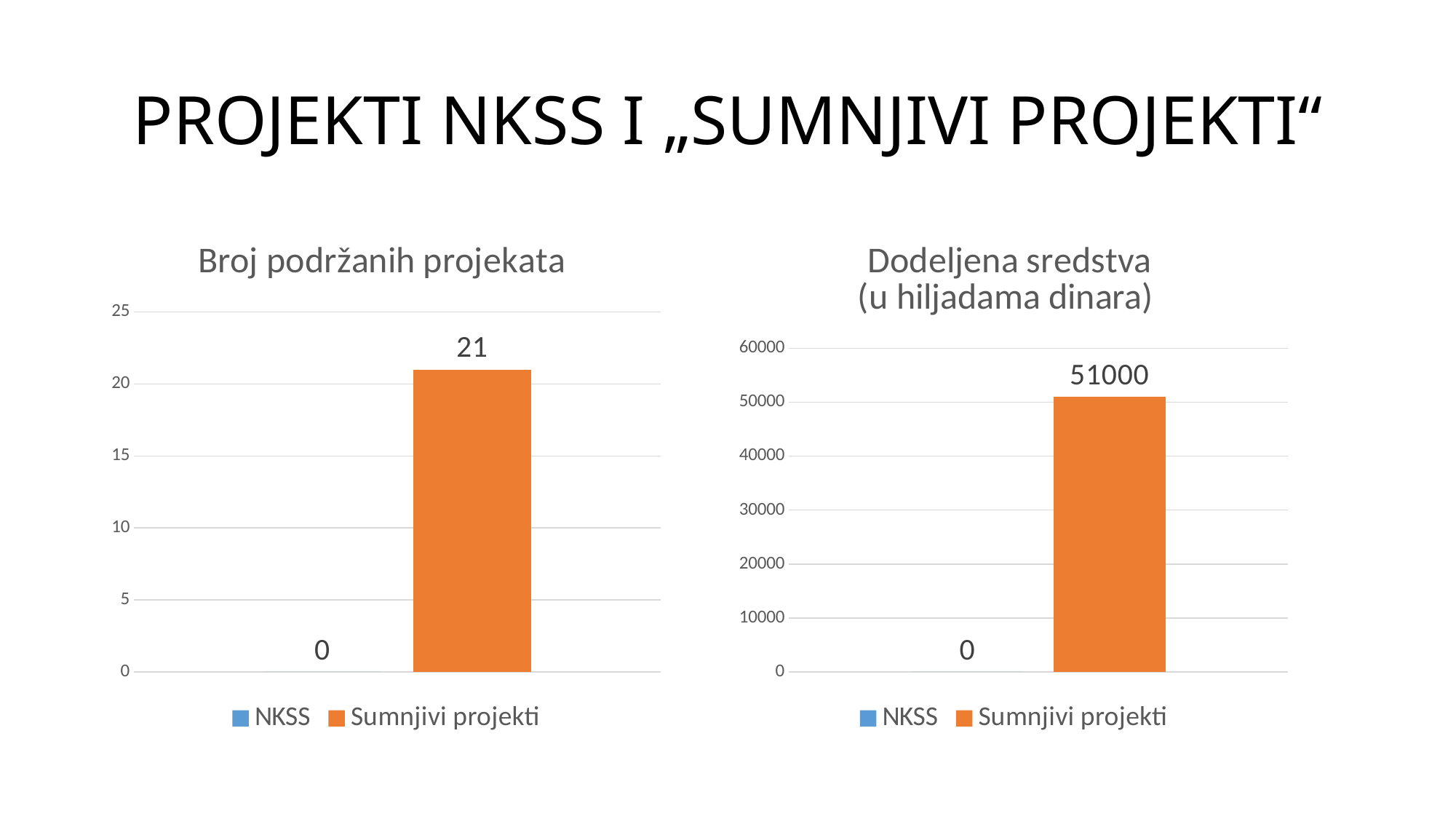
In the chart titled "Dodeljena sredstva (u hiljadama dinara)", what is the value for Sumnjivi projekti? 51000 In the chart titled "Broj podržanih projekata", what is the value for Sumnjivi projekti? 21 What colour is the Sumnjivi projekti series in the chart titled "Broj podržanih projekata"? orange In the chart titled "Broj podržanih projekata", what is the difference between the Sumnjivi projekti value and the NKSS value? 21 In the chart titled "Dodeljena sredstva (u hiljadama dinara)", what is the difference between the Sumnjivi projekti value and the NKSS value? 51000 In the chart titled "Dodeljena sredstva (u hiljadama dinara)", what is the value for NKSS? 0 How many series does the legend of the chart titled "Broj podržanih projekata" list? 2 In the chart titled "Broj podržanih projekata", which series has the higher value? Sumnjivi projekti In the chart titled "Dodeljena sredstva (u hiljadama dinara)", is the value for Sumnjivi projekti greater or less than 50000? greater What kind of chart is the chart titled "Dodeljena sredstva (u hiljadama dinara)"? bar chart In the chart titled "Broj podržanih projekata", what is the value for NKSS? 0 In the chart titled "Dodeljena sredstva (u hiljadama dinara)", which series has the lower value? NKSS